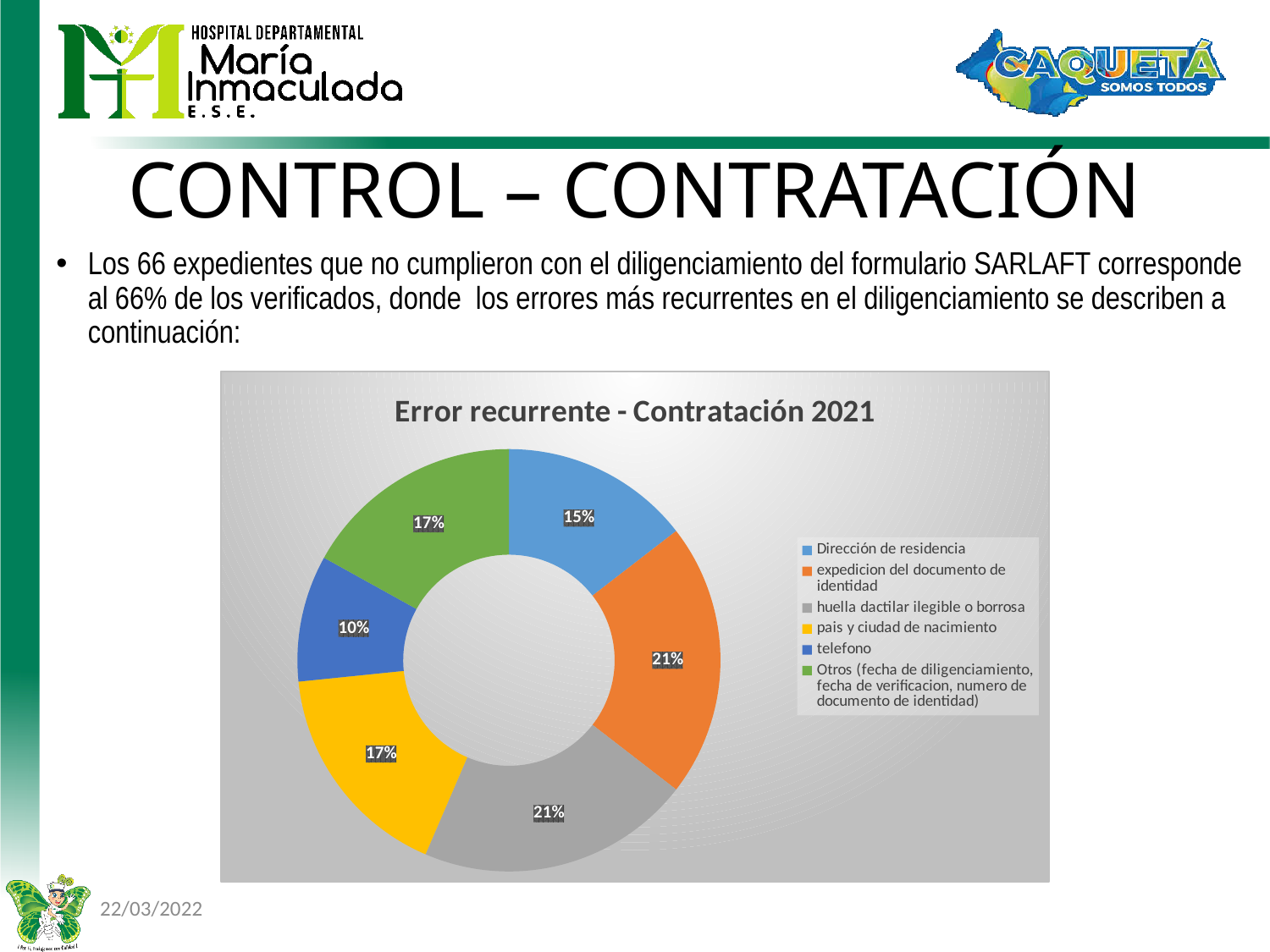
Which is larger, the share for 'Dirección de residencia' or the share for 'telefono'? Dirección de residencia What percentage is shown for 'expedicion del documento de identidad'? 21% What percentage is shown for 'pais y ciudad de nacimiento'? 17% What is the difference in percentage points between 'huella dactilar ilegible o borrosa' and 'telefono'? 11 percentage points How many categories does the legend list? 6 What colour represents 'Otros (fecha de diligenciamiento, fecha de verificacion, numero de documento de identidad)' in the chart? Green What percentage is shown for 'huella dactilar ilegible o borrosa'? 21% What share does 'telefono' have in the chart? 10% Which category has the smallest share in the chart? telefono What type of chart is shown on the slide? Doughnut (pie) chart What is the title of the chart? Error recurrente - Contratación 2021 What percentage of the chart corresponds to 'Dirección de residencia'? 15%